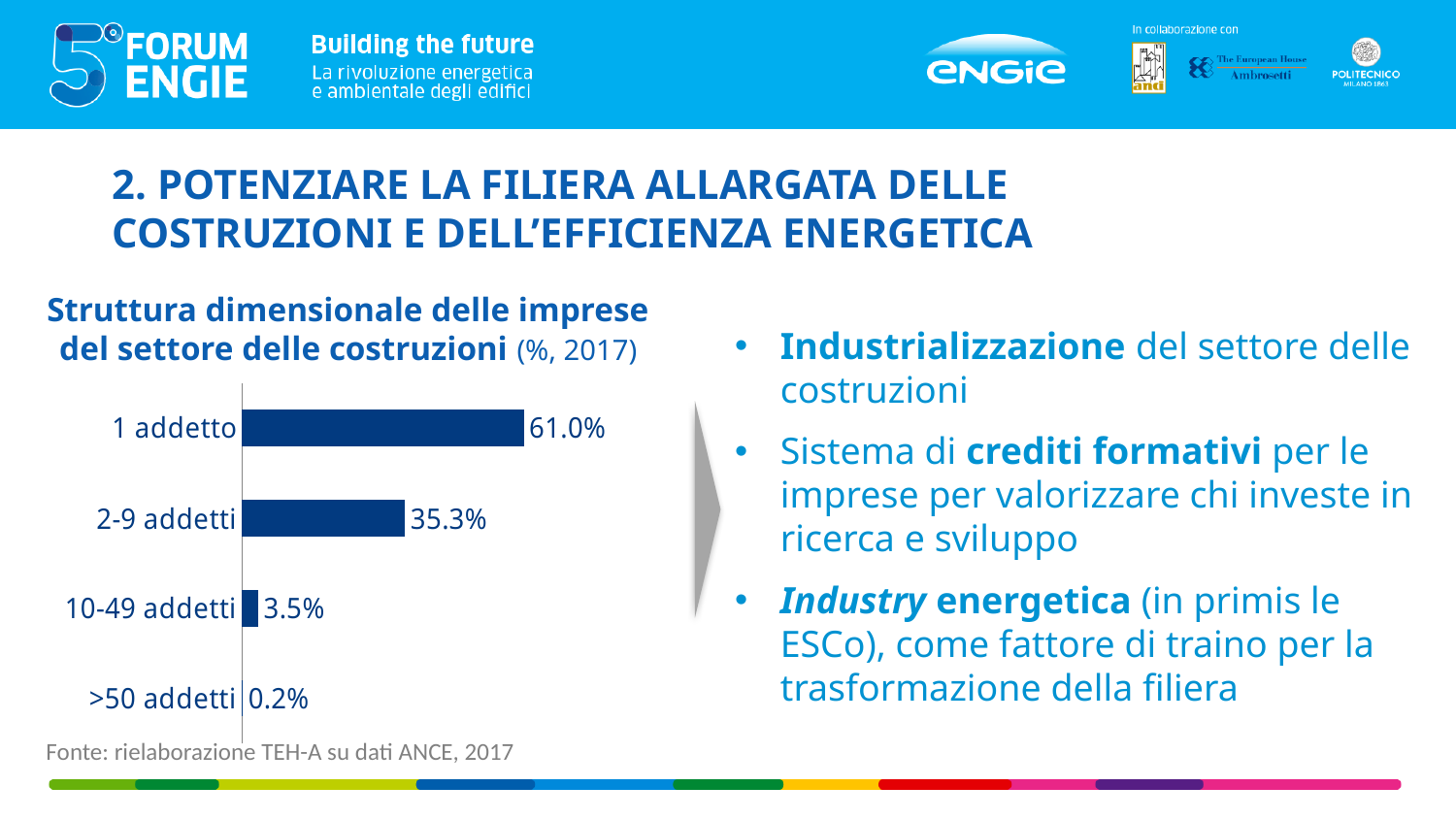
What is the difference between the values for "1 addetto" and "2-9 addetti"? 25.7% How many categories are shown in the chart? 4 What is the source cited below the chart? Fonte: rielaborazione TEH-A su dati ANCE, 2017 What kind of chart is shown on the slide? Bar chart Which category has the highest value? 1 addetto Which category has the lowest value? >50 addetti What is the value for ">50 addetti"? 0.2% What is the value for "10-49 addetti"? 3.5% What is the value for "1 addetto"? 61.0% What is the title of the chart? Struttura dimensionale delle imprese del settore delle costruzioni (%, 2017) What is the value for "2-9 addetti"? 35.3% Which is larger, the value for "10-49 addetti" or ">50 addetti"? 10-49 addetti